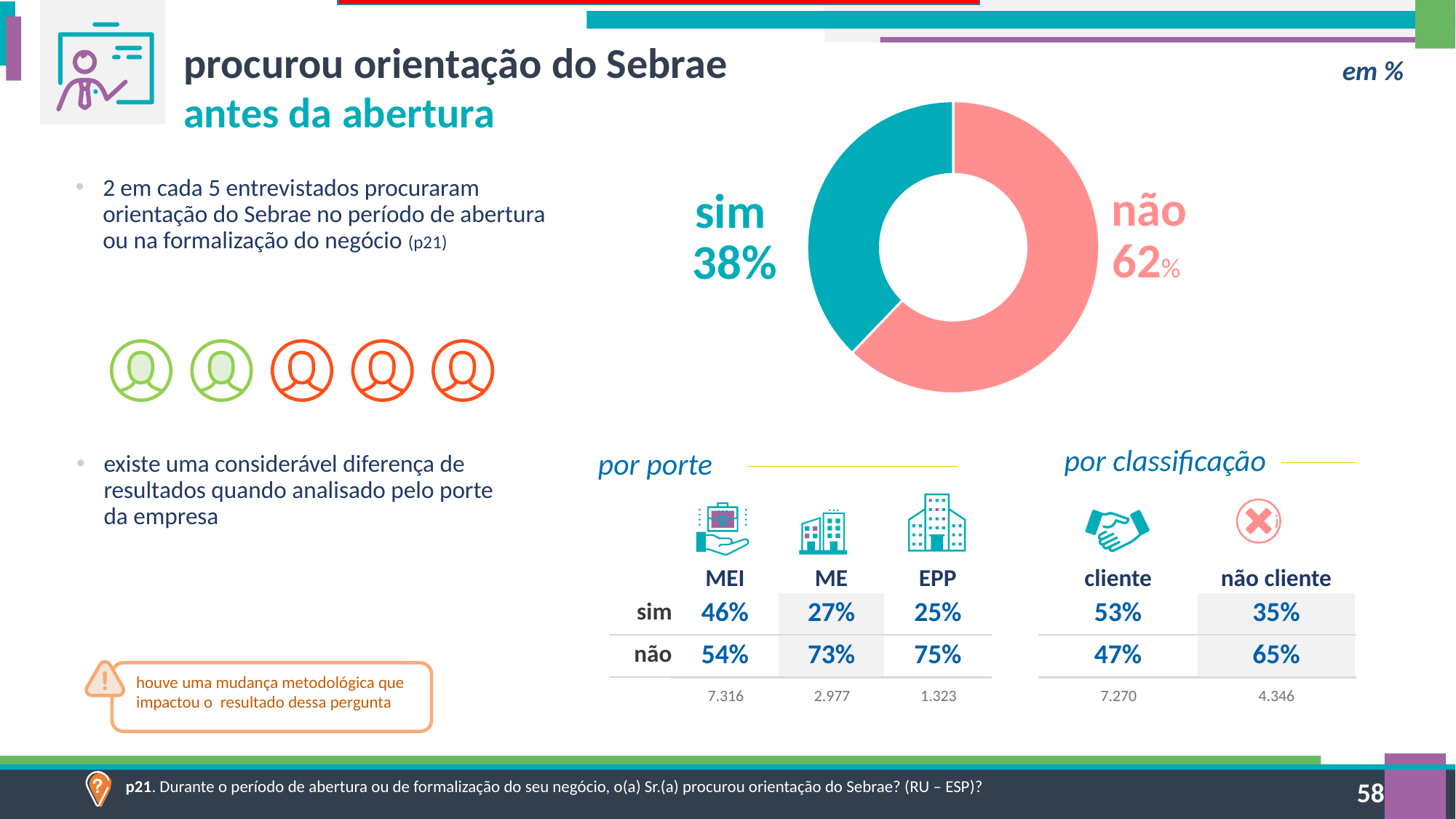
What is the total of the two slices shown in the pie chart? 100% Which is larger in the pie chart, "sim" or "não"? não What is the difference in percentage points between the "não" and "sim" slices of the pie chart? 24 Which slice of the pie chart is the largest? não How many slices does the pie chart have? 2 What share of respondents answered "não" in the pie chart? 62% What kind of chart is shown on the slide? Pie chart (donut) What share of respondents answered "sim" in the pie chart? 38% Which slice of the pie chart is the smallest? sim What colour is the "sim" slice of the pie chart? Teal What colour is the "não" slice of the pie chart? Pink